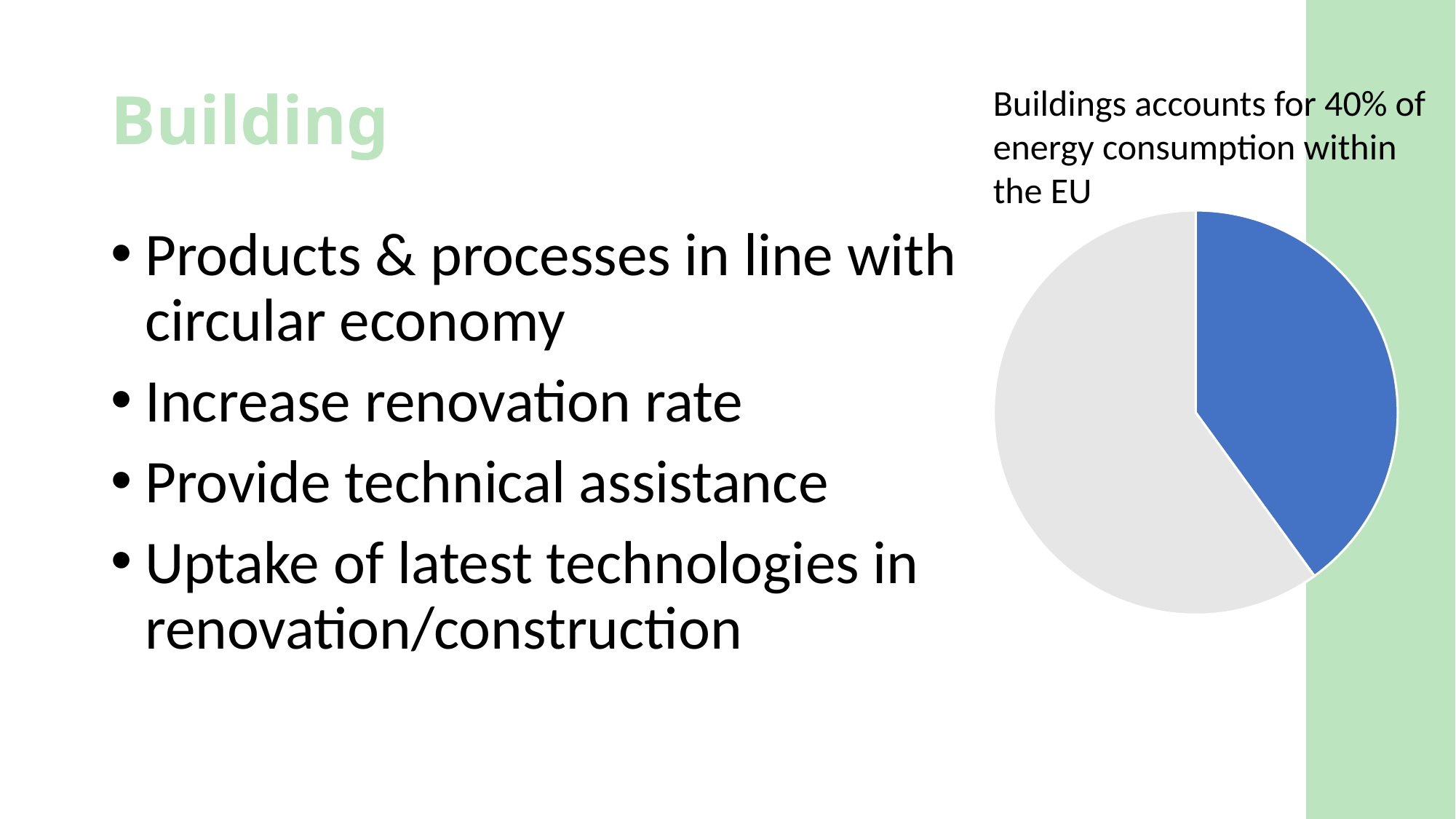
What colour is the smaller slice of the pie chart? blue According to the chart's title, what share of energy consumption within the EU do buildings account for? 40% What is the title text shown above the pie chart? Buildings accounts for 40% of energy consumption within the EU Is the share represented by the blue slice greater or less than 50%? less How many slices does the pie chart have? 2 Which slice of the pie chart is larger, the blue slice or the grey slice? the grey slice Is the share represented by the grey slice greater or less than 50%? greater What kind of chart is shown on the slide? pie chart